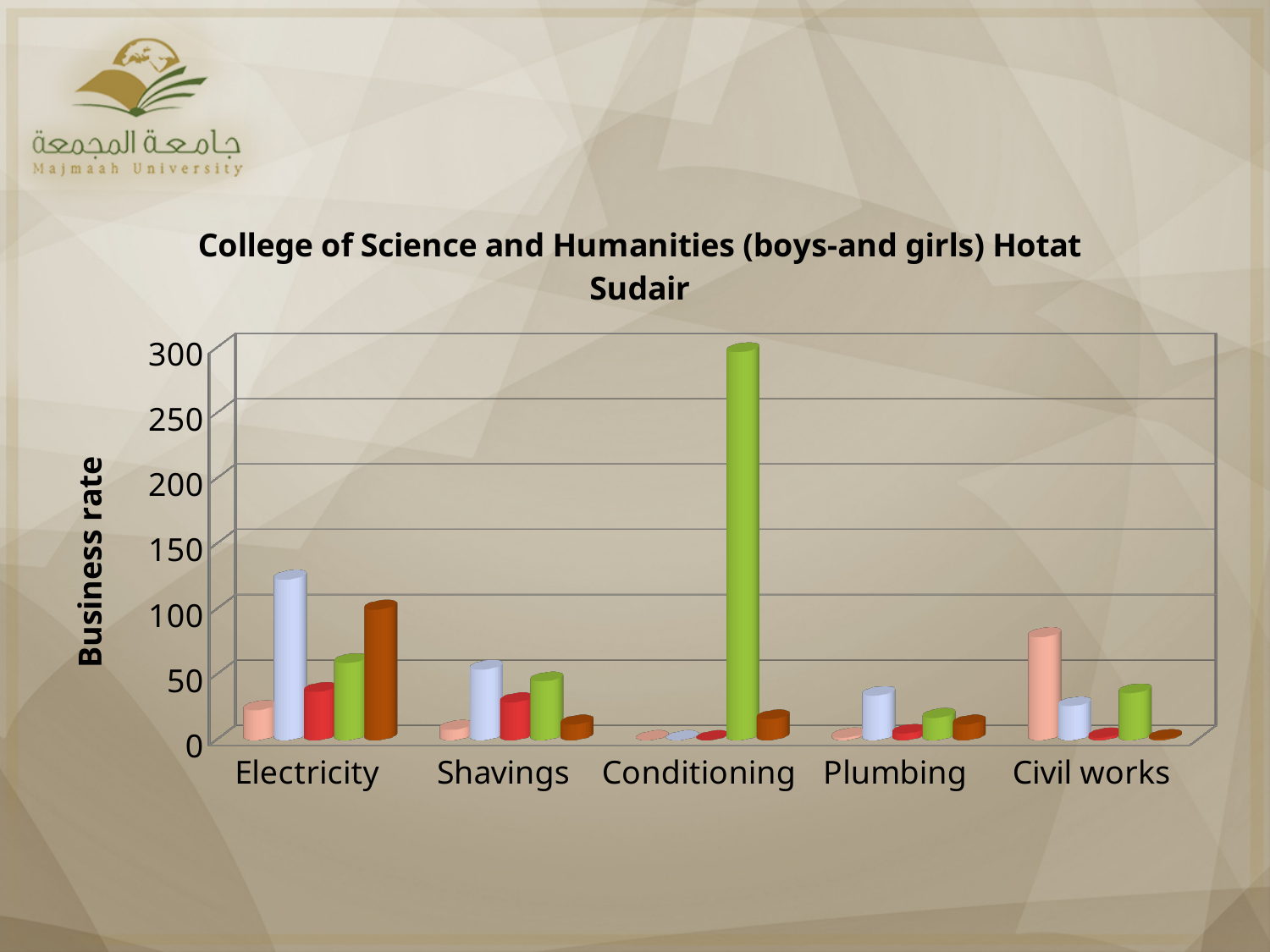
How many bars are plotted for each category? 5 Is the value of the peach bar for Civil works greater or less than 50? greater Which category contains the tallest bar in the chart? Conditioning How many categories are shown on the x axis of the chart? 5 Is the value of the green bar for Conditioning greater or less than 250? greater What kind of chart is shown on the slide? bar chart What is the title of the chart? College of Science and Humanities (boys-and girls) Hotat Sudair Which is larger: the light blue bar for Electricity or the light blue bar for Plumbing? Electricity What is the label on the vertical axis of the chart? Business rate Is the value of the brown bar for Electricity greater or less than 150? less Which is larger: the green bar for Conditioning or the green bar for Electricity? Conditioning